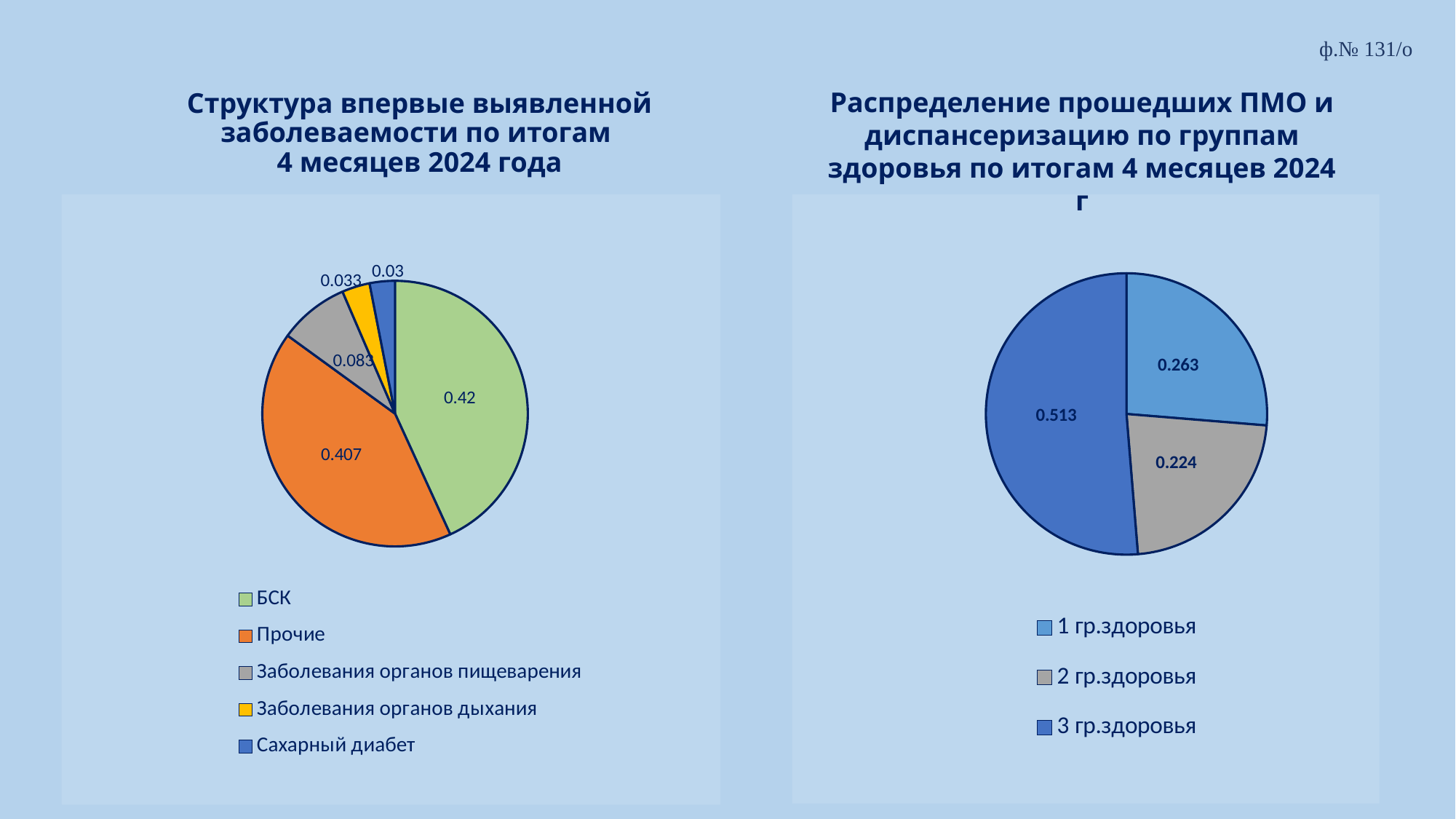
In the left chart, which is larger: Заболевания органов дыхания or Сахарный диабет? Заболевания органов дыхания How many categories does the left chart's legend list? 5 In the left chart, what is the difference between the values for Прочие and Заболевания органов пищеварения? 0.324 In the right chart, what colour is the slice for 1 гр.здоровья? Light blue In the right chart, 'Распределение прошедших ПМО и диспансеризацию по группам здоровья', what is the value for 2 гр.здоровья? 0.224 In the left chart, what is the value for БСК? 0.42 In the left chart, which category has the smallest slice? Сахарный диабет How many slices does the right chart have? 3 What type of chart is the left chart, 'Структура впервые выявленной заболеваемости по итогам 4 месяцев 2024 года'? Pie chart In the right chart, what is the difference between the values for 3 гр.здоровья and 1 гр.здоровья? 0.25 In the right chart, which health group has the largest slice? 3 гр.здоровья In the left chart, what is the value for Заболевания органов пищеварения? 0.083